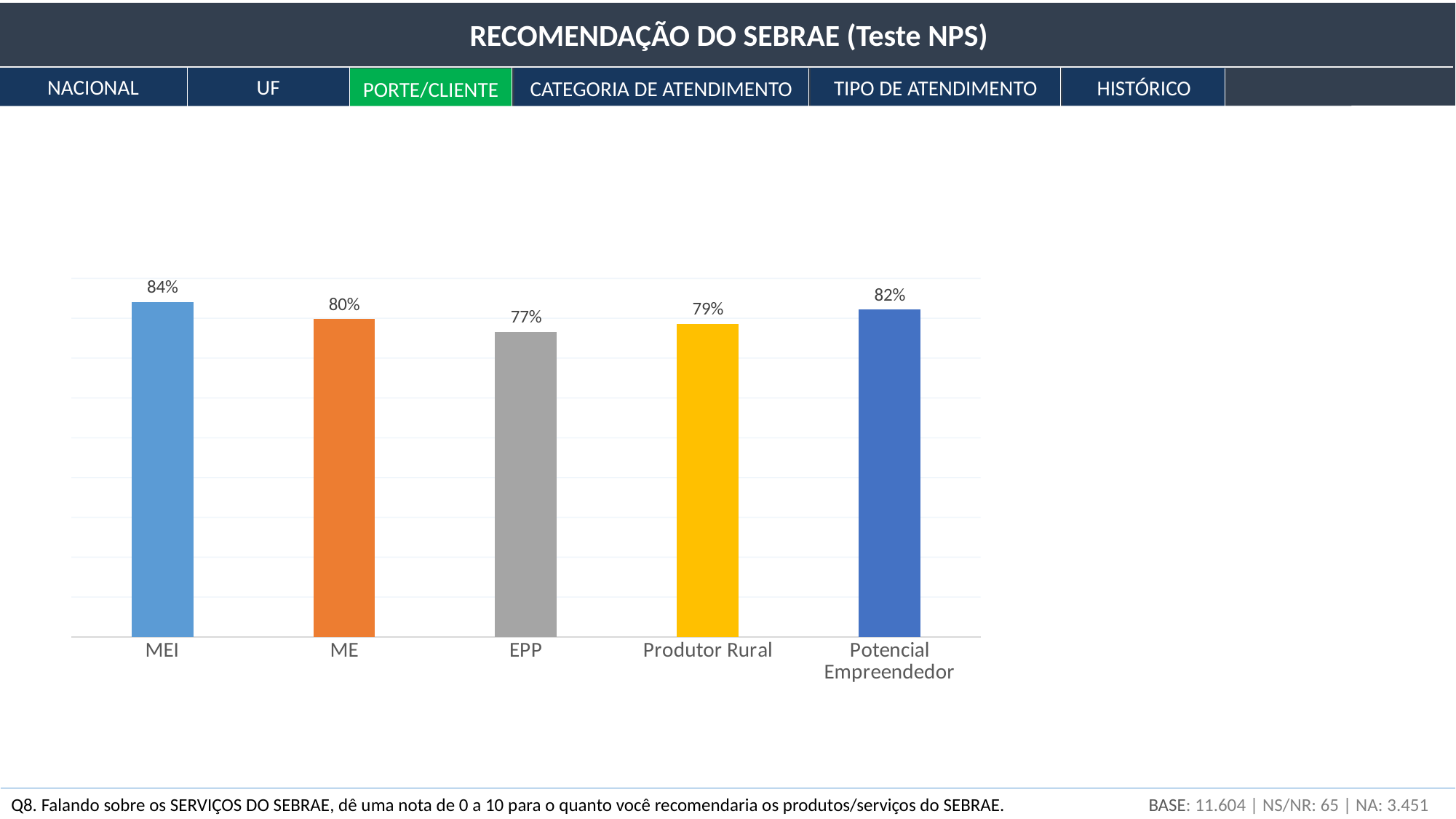
What is the value for EPP? 77% What is the difference between the values for Potencial Empreendedor and ME? 2% Which category has the lowest value? EPP What kind of chart is shown on the slide? Bar chart What colour is the bar for Produtor Rural? Yellow Which category has the highest value? MEI Which is larger, the value for ME or the value for Produtor Rural? ME What is the value for MEI? 84% What is the difference between the values for MEI and EPP? 7% How many categories are shown in the chart? 5 What is the value for Produtor Rural? 79% What is the value for Potencial Empreendedor? 82%